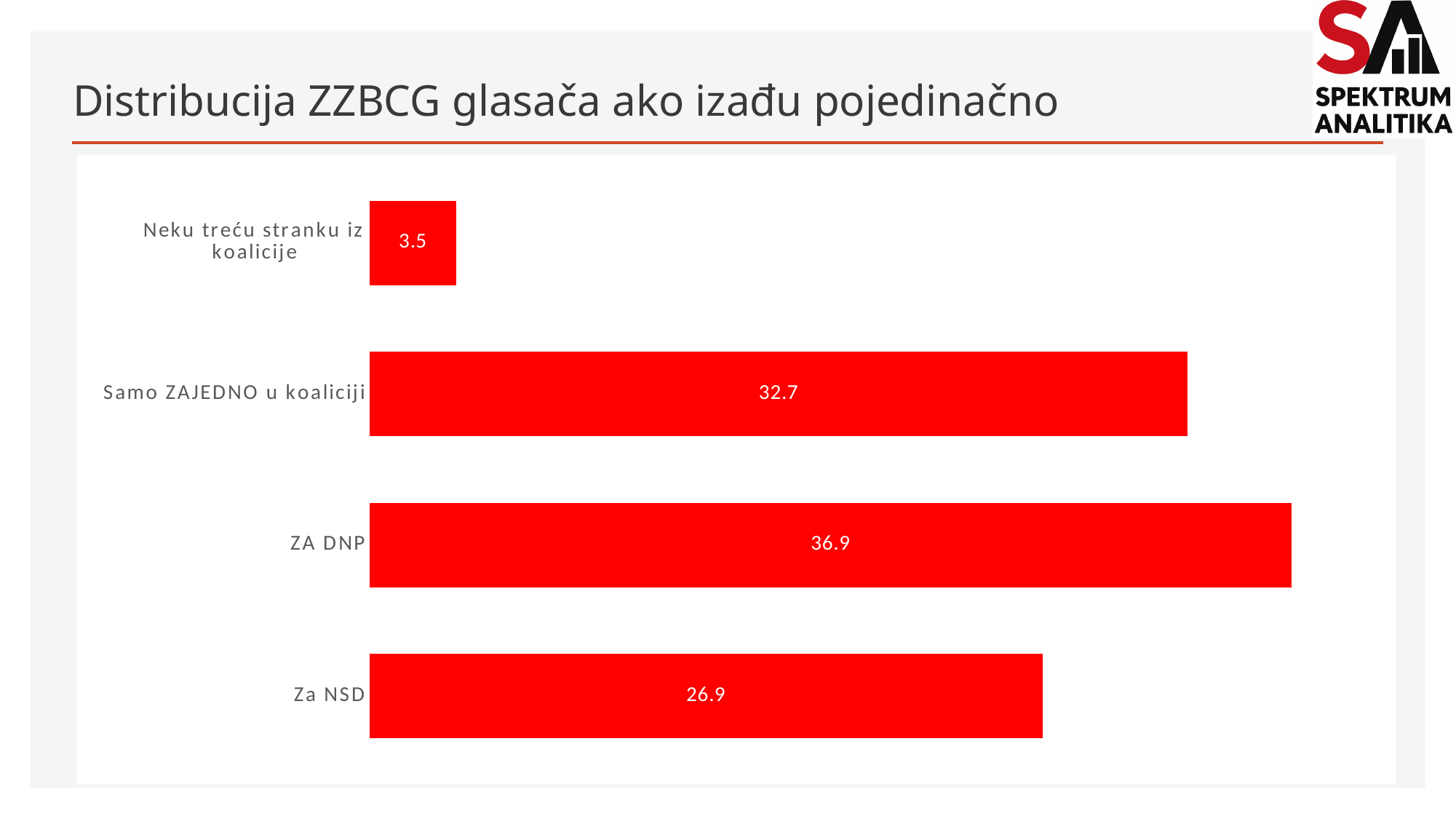
How many categories are shown in the chart? 4 What kind of chart is shown on the slide? Bar chart Which is larger, the value for Samo ZAJEDNO u koaliciji or the value for Za NSD? Samo ZAJEDNO u koaliciji What is the difference between the values for ZA DNP and Za NSD? 10 What is the value for Za NSD? 26.9 What is the difference between the values for Samo ZAJEDNO u koaliciji and Neku treću stranku iz koalicije? 29.2 What is the title of the chart on the slide? Distribucija ZZBCG glasača ako izađu pojedinačno What is the value for Samo ZAJEDNO u koaliciji? 32.7 What is the value for Neku treću stranku iz koalicije? 3.5 What is the value for ZA DNP? 36.9 Which category has the lowest value? Neku treću stranku iz koalicije Which category has the highest value? ZA DNP